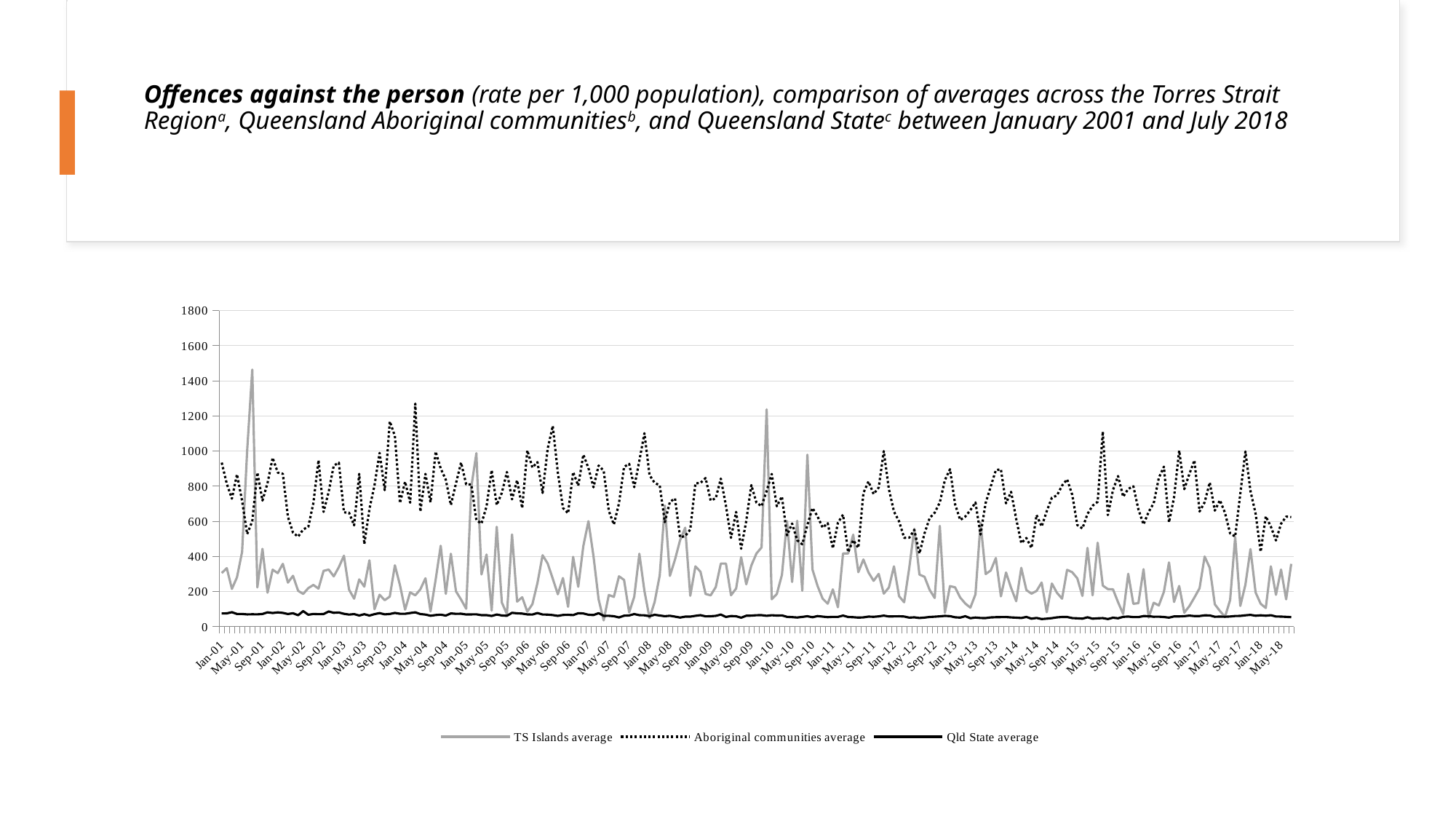
Is the peak value of TS Islands average around Sep-01 greater or less than 1200? greater Which offence category does the chart title say the rates are for? Offences against the person How many series does the legend list? 3 What type of chart is shown on the slide? line chart Is the value for Aboriginal communities average in May-18 greater or less than 400? greater Is the value for Qld State average in Jan-01 greater or less than 200? less Which series stays lowest across the whole period? Qld State average What are the three series named in the legend? TS Islands average, Aboriginal communities average, Qld State average Around Jan-10, which is larger: TS Islands average or Qld State average? TS Islands average Which series is generally the highest across the period? Aboriginal communities average